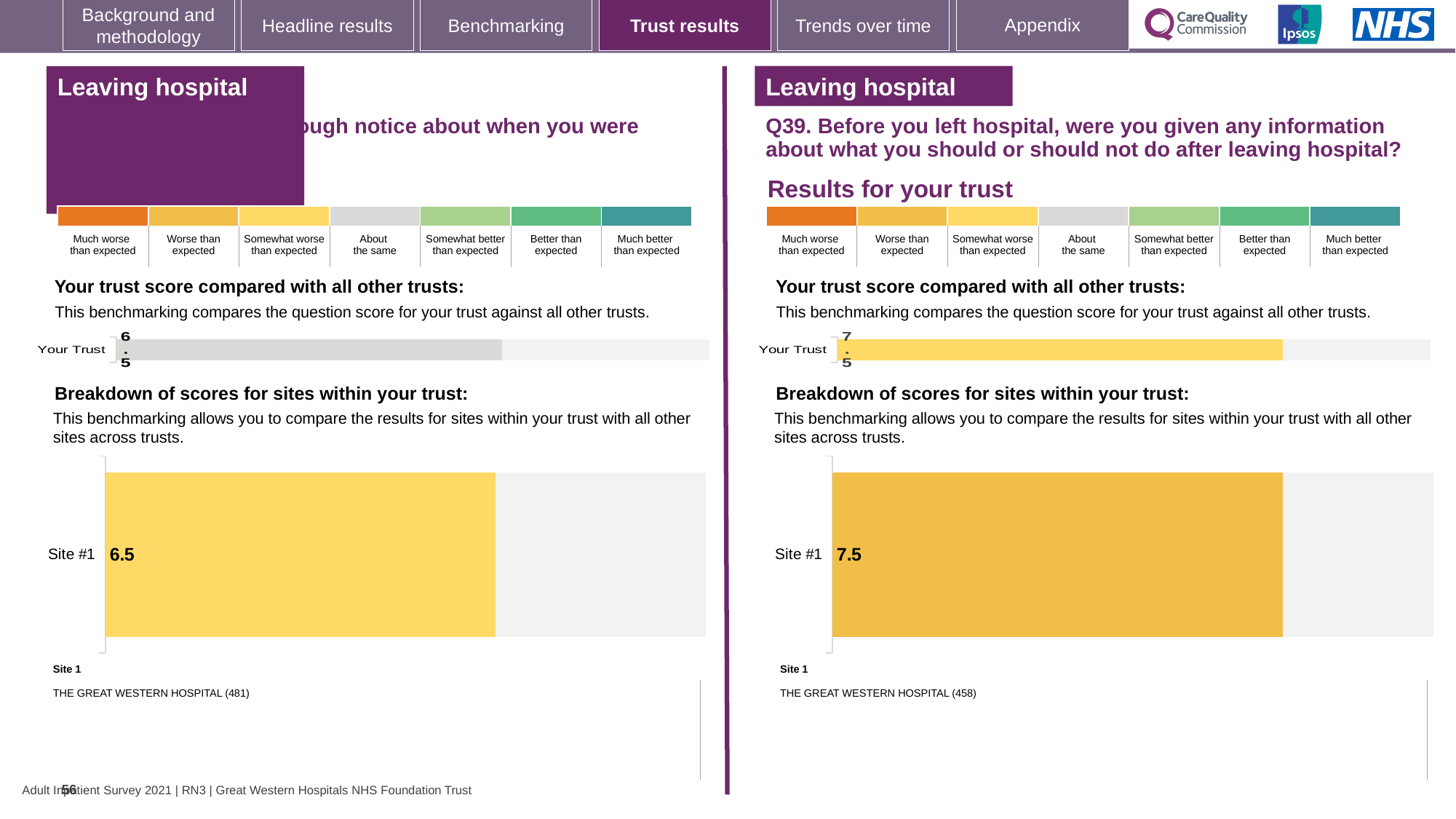
How many sites are shown in the 'Breakdown of scores for sites within your trust' chart on the left half of the slide? 1 On the right half of the slide (Q39), what is the score shown for Your Trust in the 'Your trust score compared with all other trusts' chart? 7.5 On the right half of the slide (Q39), what is the score for Site #1 in the 'Breakdown of scores for sites within your trust' chart? 7.5 On the left half of the slide, what is the score shown for Your Trust in the 'Your trust score compared with all other trusts' chart? 6.5 What is the difference between the Site #1 score on the right half (Q39) and the Site #1 score on the left half of the slide? 1.0 What kind of chart is used to show the Site #1 score on the right half of the slide (Q39)? Bar chart On the left half of the slide, what is the score for Site #1 in the 'Breakdown of scores for sites within your trust' chart? 6.5 How many sites are shown in the 'Breakdown of scores for sites within your trust' chart on the right half of the slide (Q39)? 1 What kind of chart is used to show the Your Trust score on the left half of the slide? Bar chart Which is larger: the Site #1 score on the left half of the slide or the Site #1 score on the right half (Q39)? Right half (Q39), 7.5 On the left half of the slide, which site is listed as Site 1 below the breakdown chart? THE GREAT WESTERN HOSPITAL (481) On the right half of the slide (Q39), which site is listed as Site 1 below the breakdown chart? THE GREAT WESTERN HOSPITAL (458)